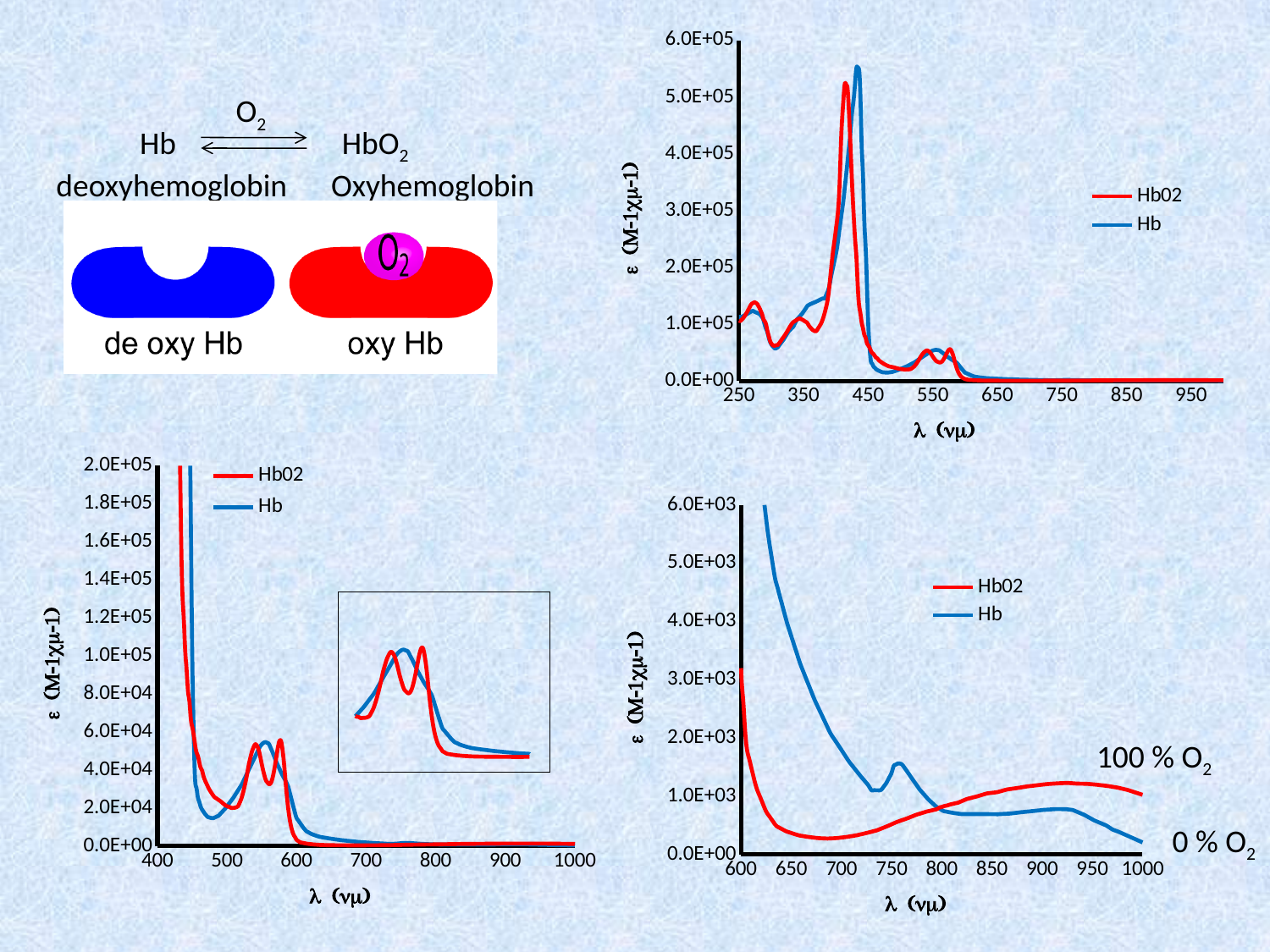
In the bottom-right chart, is the value of Hb02 at 600 greater or less than 4.0E+03? less In the top-right chart, which series is drawn in red? Hb02 In the top-right chart, is the value of Hb02 at 750 greater or less than 1.0E+05? less In the bottom-right chart, is the value of Hb at 650 greater or less than 2.0E+03? greater In the bottom-right chart, which series has the larger value at 900, Hb or Hb02? Hb02 In the bottom-right chart, does the Hb series rise or fall between 600 and 700? fall In the bottom-right chart, which series has the larger value at 600, Hb or Hb02? Hb How many series does the legend of the top-right chart list? 2 What type of chart is the top-right chart? line chart How many charts are shown on the slide? 3